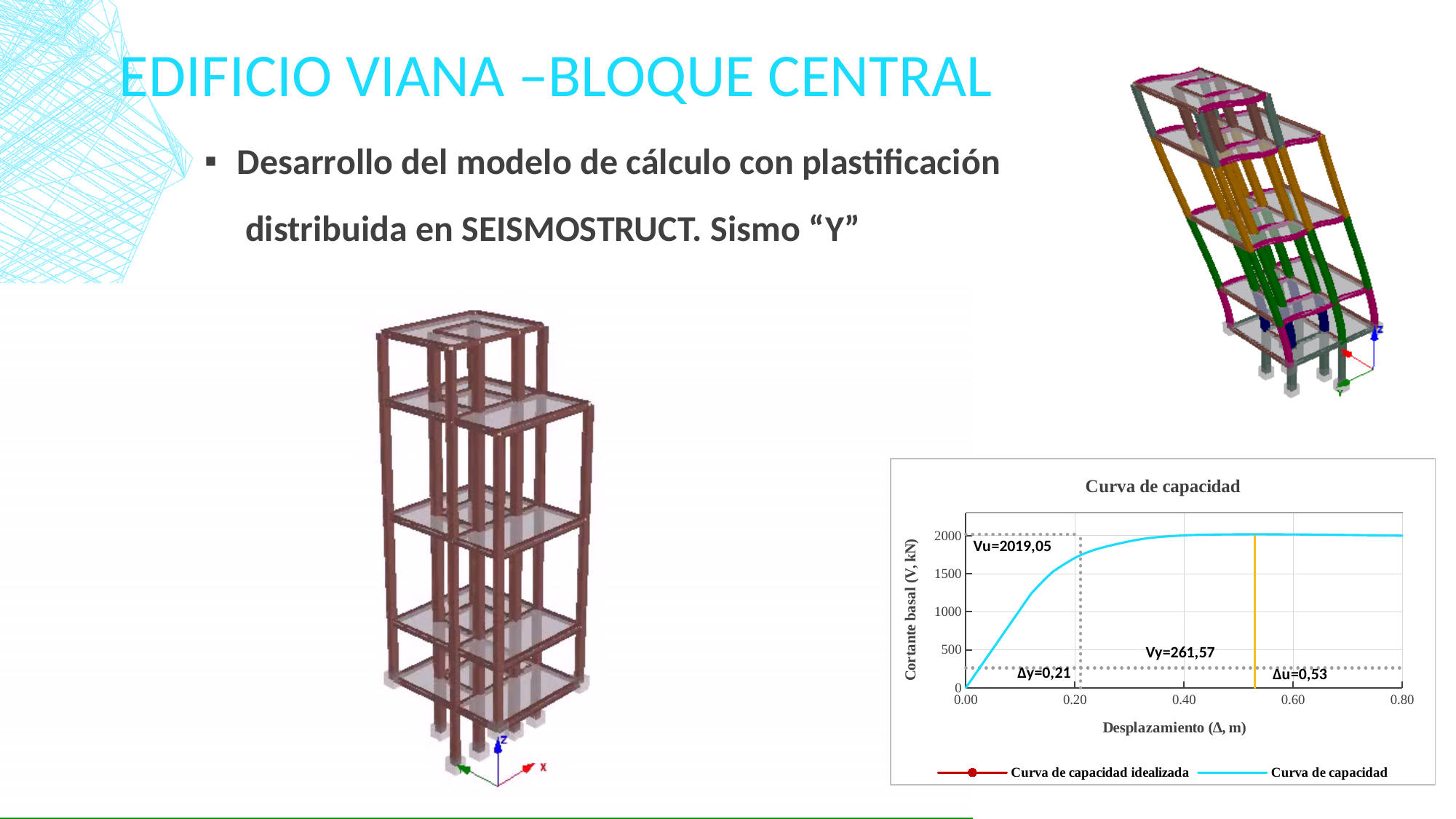
What value of Δu is labelled on the chart? Δu=0,53 Is the base shear of the capacity curve at a displacement of 0.10 m greater or less than 1500 kN? less Which is larger, the labelled Vu value or the labelled Vy value? Vu Does the capacity curve rise or fall as displacement increases from 0.00 to 0.20 m? rise What value of Vy is labelled on the chart? Vy=261,57 How many series does the chart legend list? 2 What value of Vu is labelled on the chart? Vu=2019,05 What is the label of the vertical axis of the chart? Cortante basal (V, kN) What type of chart is shown on the slide? line chart Is the base shear of the capacity curve at a displacement of 0.40 m greater or less than 1500 kN? greater What value of Δy is labelled on the chart? Δy=0,21 What is the title of the chart? Curva de capacidad